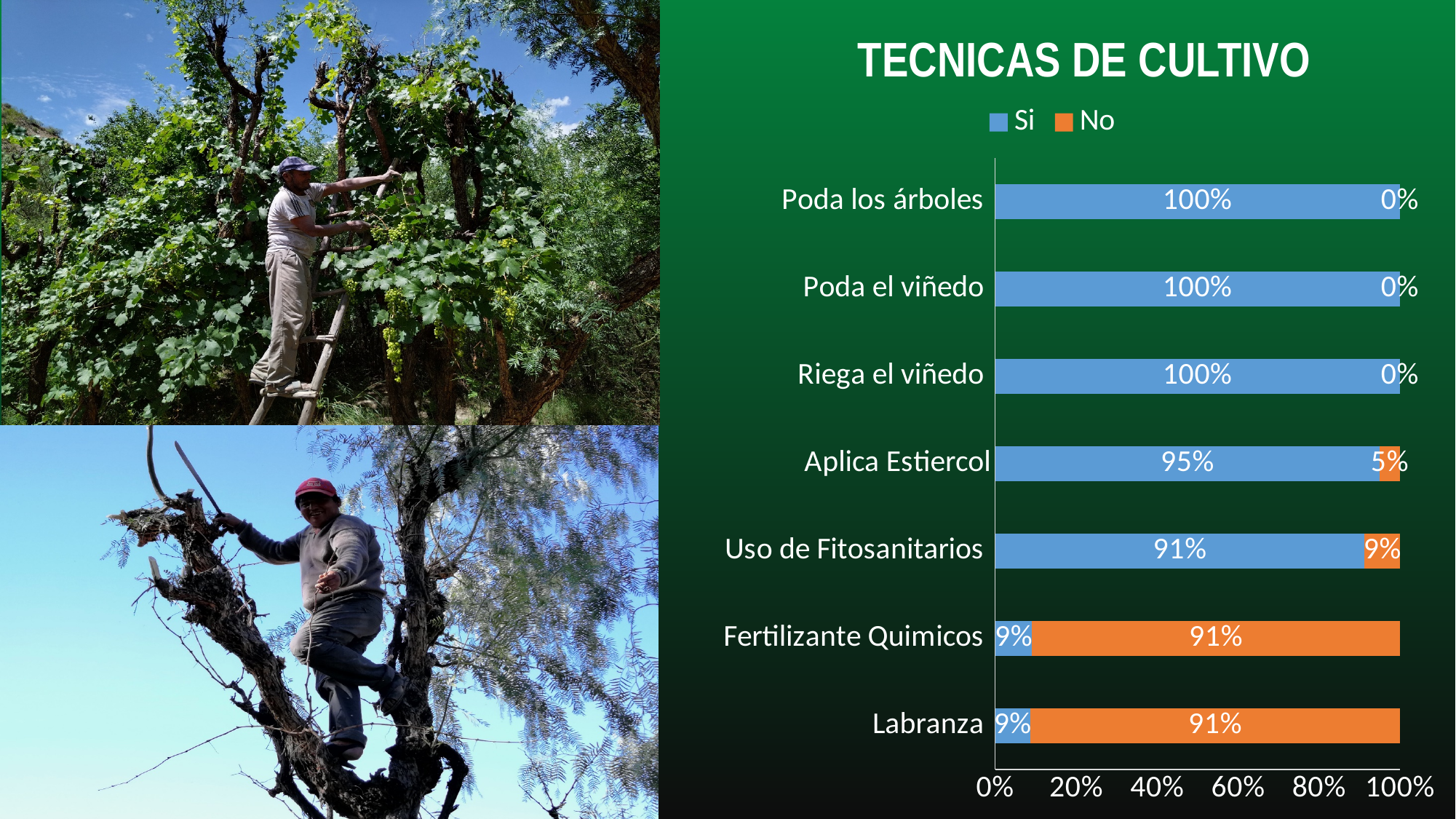
What is the title of the chart? TECNICAS DE CULTIVO What kind of chart is shown on the slide? Bar chart How many series does the legend list? 2 What is the total of the stacked bar for Uso de Fitosanitarios? 100% What is the difference between the 'Si' and 'No' values for Aplica Estiercol? 90% Which is larger: the 'Si' value for Uso de Fitosanitarios or the 'Si' value for Labranza? Uso de Fitosanitarios What is the 'No' value for Labranza? 91% What is the 'Si' value for Aplica Estiercol? 95% What is the 'Si' value for Fertilizante Quimicos? 9% Which category has the highest 'No' value? Fertilizante Quimicos and Labranza What is the 'No' value for Uso de Fitosanitarios? 9% How many categories are shown on the chart? 7